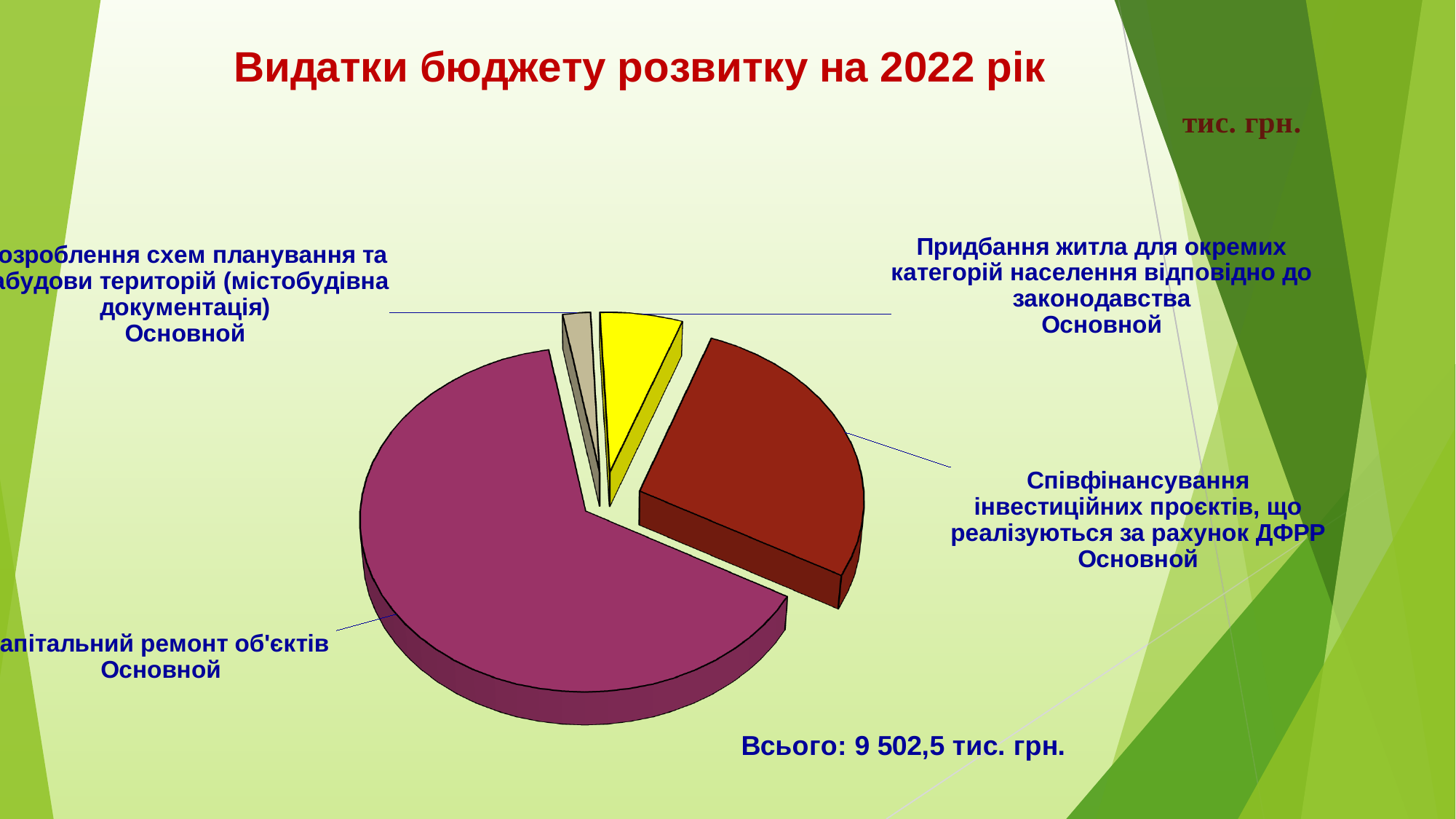
Which slice is larger: Придбання житла для окремих категорій населення відповідно до законодавства or Розроблення схем планування та забудови територій (містобудівна документація)? Придбання житла для окремих категорій населення відповідно до законодавства Which category has the smallest slice of the pie chart? Розроблення схем планування та забудови територій (містобудівна документація) Which slice is larger: Співфінансування інвестиційних проєктів, що реалізуються за рахунок ДФРР or Придбання житла для окремих категорій населення відповідно до законодавства? Співфінансування інвестиційних проєктів, що реалізуються за рахунок ДФРР Which slice is larger: Капітальний ремонт об'єктів or Співфінансування інвестиційних проєктів, що реалізуються за рахунок ДФРР? Капітальний ремонт об'єктів How many slices does the pie chart have? 4 Which category has the largest slice of the pie chart? Капітальний ремонт об'єктів What is the title of the slide containing the pie chart? Видатки бюджету розвитку на 2022 рік What total amount is stated below the pie chart? 9 502,5 тис. грн. What kind of chart is shown on the slide? pie chart